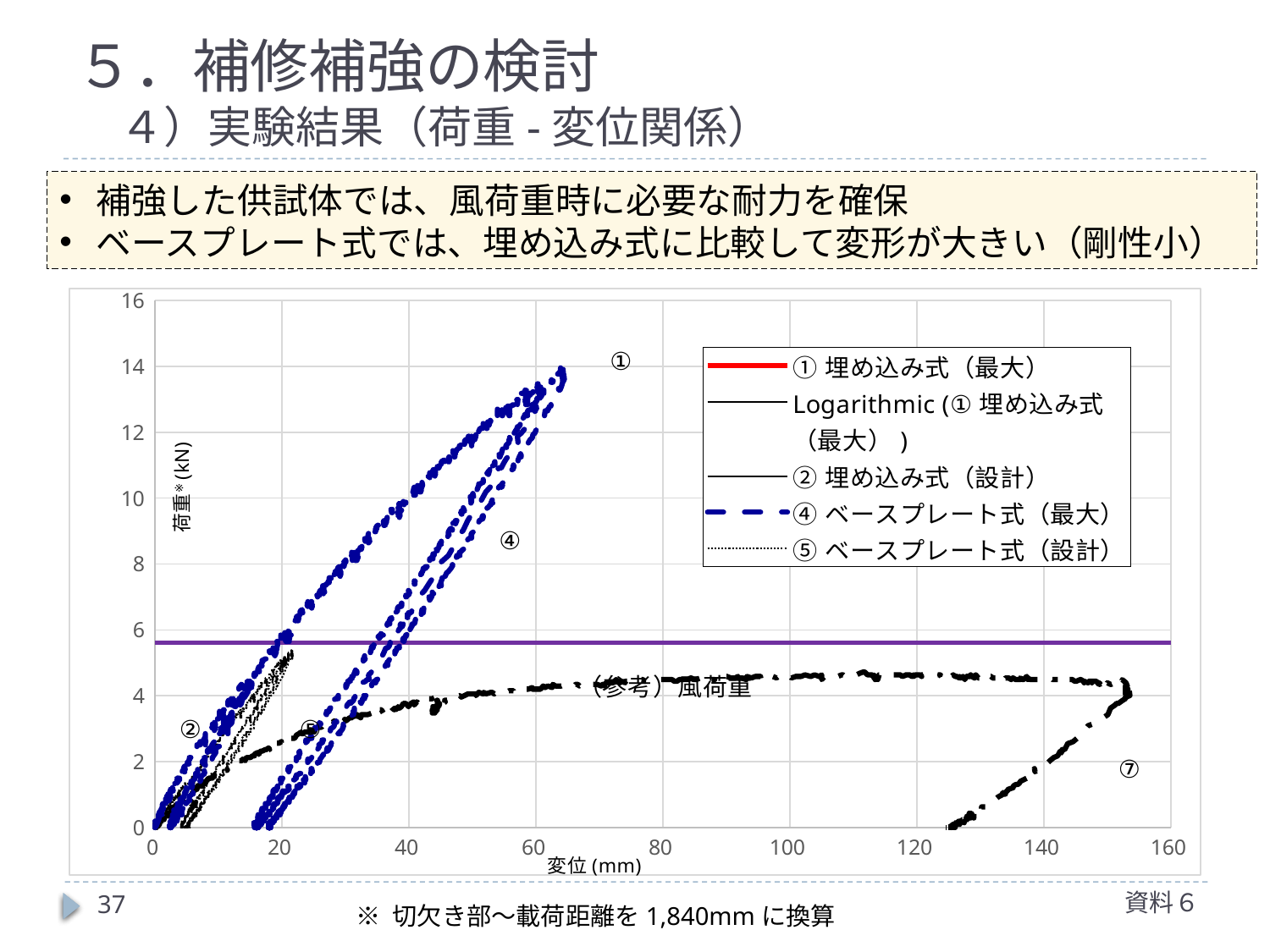
What is the title of the x axis of the chart? 変位 (mm) Is the maximum displacement reached by curve ⑦ greater or less than 140 mm? greater Is the peak load reached by curve ② greater or less than 8 kN? less Which curve reaches a larger displacement, ④ or ⑦? ⑦ Is the peak load reached by curve ① greater or less than 12 kN? greater Does the load of curve ⑦ rise or fall as displacement increases from 0 to about 150 mm? rise What is the maximum value shown on the y axis (荷重) of the chart? 16 Which curve reaches a higher peak load, ① or ⑦? ① What kind of chart is shown on the slide? line chart How many series does the chart legend list? 5